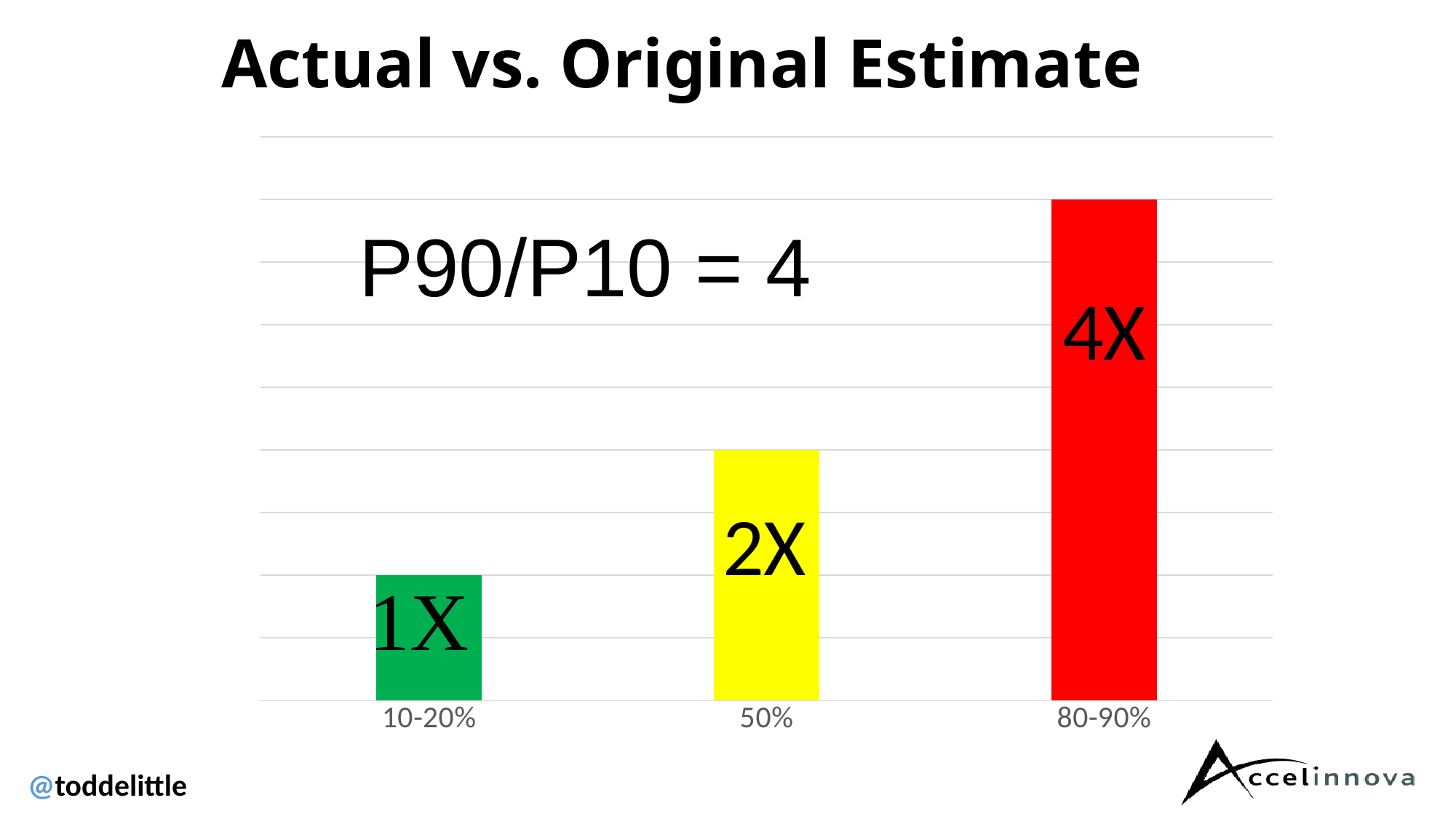
Which bar is taller, the one for 50% or the one for 10-20%? 50% What kind of chart is shown on the slide? bar chart What value is labelled on the bar for the 50% category? 2X What colour is the bar for the 80-90% category? red How many bars are plotted in the chart? 3 Which category has the highest bar? 80-90% What is the title of the chart? Actual vs. Original Estimate Which category has the lowest bar? 10-20% What value is labelled on the bar for the 80-90% category? 4X What ratio is stated in the text annotation on the chart? P90/P10 = 4 Do the bar values rise or fall from left to right across the categories? rise What value is labelled on the bar for the 10-20% category? 1X